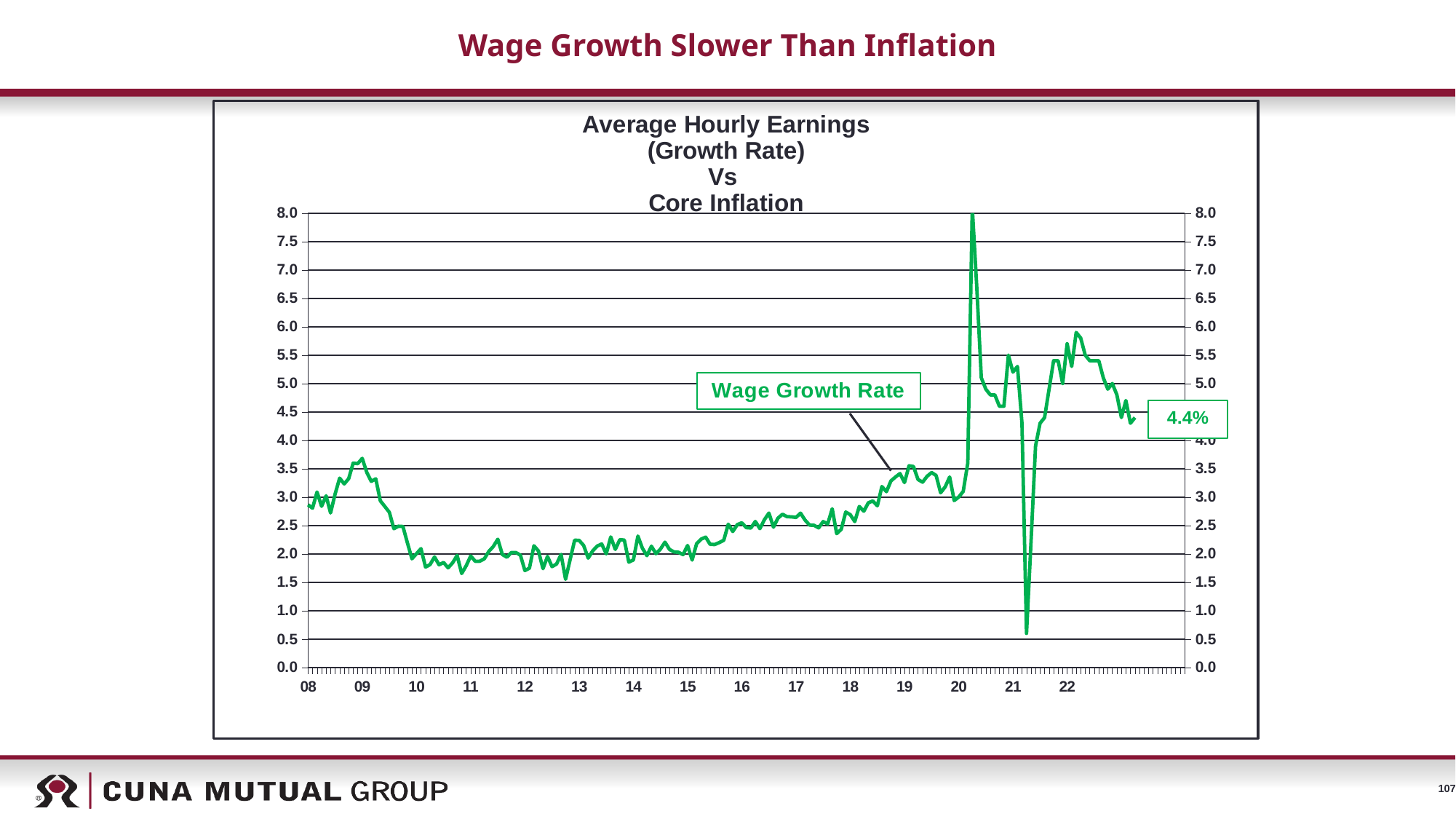
Is the Wage Growth Rate during 2012 greater or less than 3.0? less Is the peak value of the Wage Growth Rate in 2020 greater or less than 7.0? greater How many year labels are shown on the x axis? 15 What is the name of the series labelled on the chart? Wage Growth Rate Is the Wage Growth Rate at the start of 2008 greater or less than 2.0? greater What kind of chart is shown on the slide? line chart Does the Wage Growth Rate rise or fall from its 2022 peak to the end of the line? fall What is the latest value of the Wage Growth Rate shown at the end of the line? 4.4% What is the title of the chart? Average Hourly Earnings (Growth Rate) Vs Core Inflation In which year does the Wage Growth Rate reach its highest point? 20 In which year does the Wage Growth Rate reach its lowest point? 21